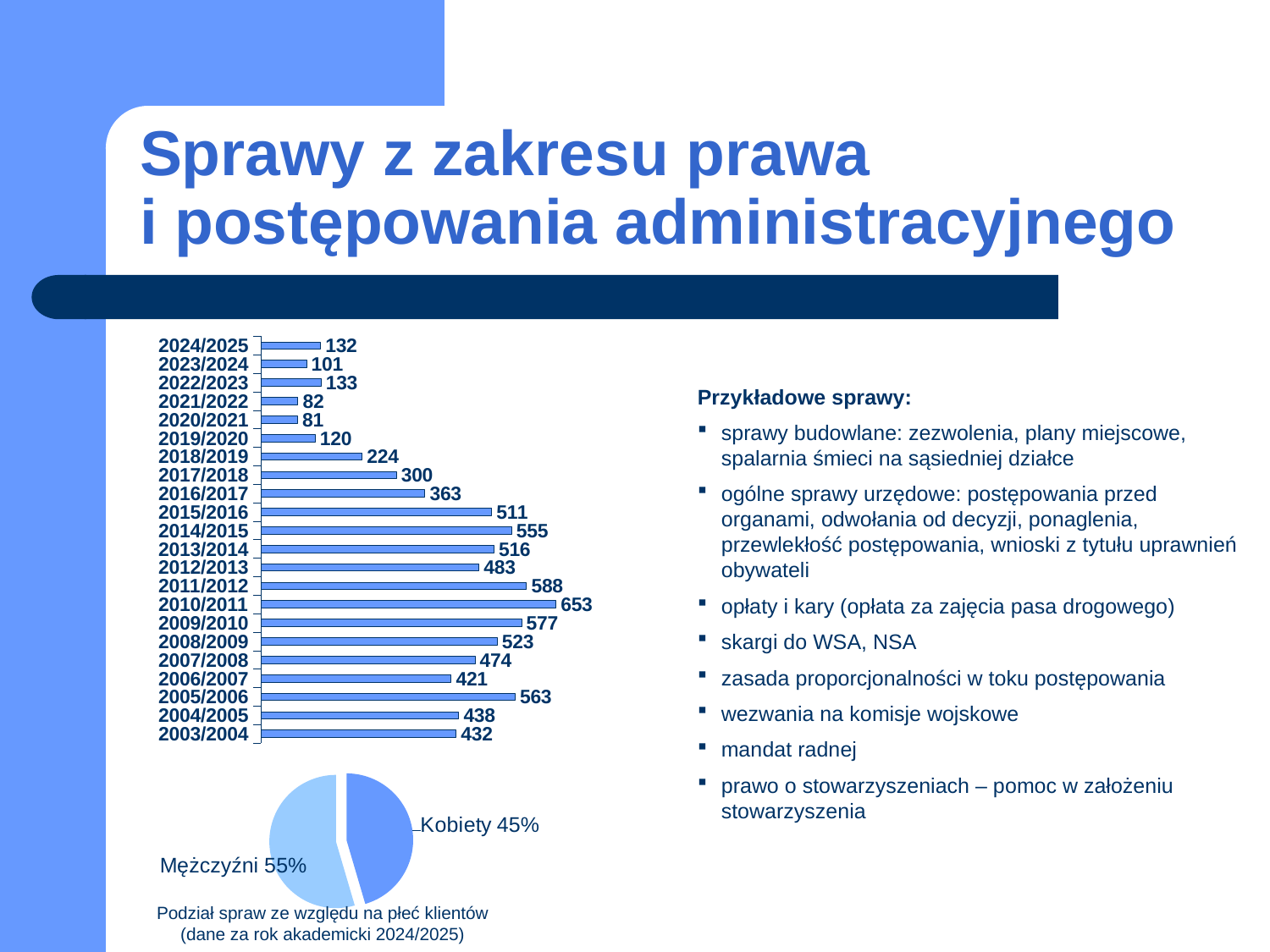
In the bar chart on the left, which is larger: the value for 2017/2018 or the value for 2018/2019? 2017/2018 In the bar chart on the left, what is the difference between the values for 2005/2006 and 2006/2007? 142 In the bar chart on the left, what is the value for 2010/2011? 653 What kind of chart is the chart at the top left of the slide? bar chart How many academic years are shown in the bar chart on the left? 22 What kind of chart is the chart at the bottom left of the slide? pie chart In the pie chart at the bottom left, what share is labelled Kobiety? 45% In the bar chart on the left, what is the value for 2003/2004? 432 In the bar chart on the left, which academic year has the highest value? 2010/2011 In the bar chart on the left, what is the value for 2024/2025? 132 In the bar chart on the left, which academic year has the lowest value? 2020/2021 In the pie chart at the bottom left, what share is labelled Mężczyźni? 55%